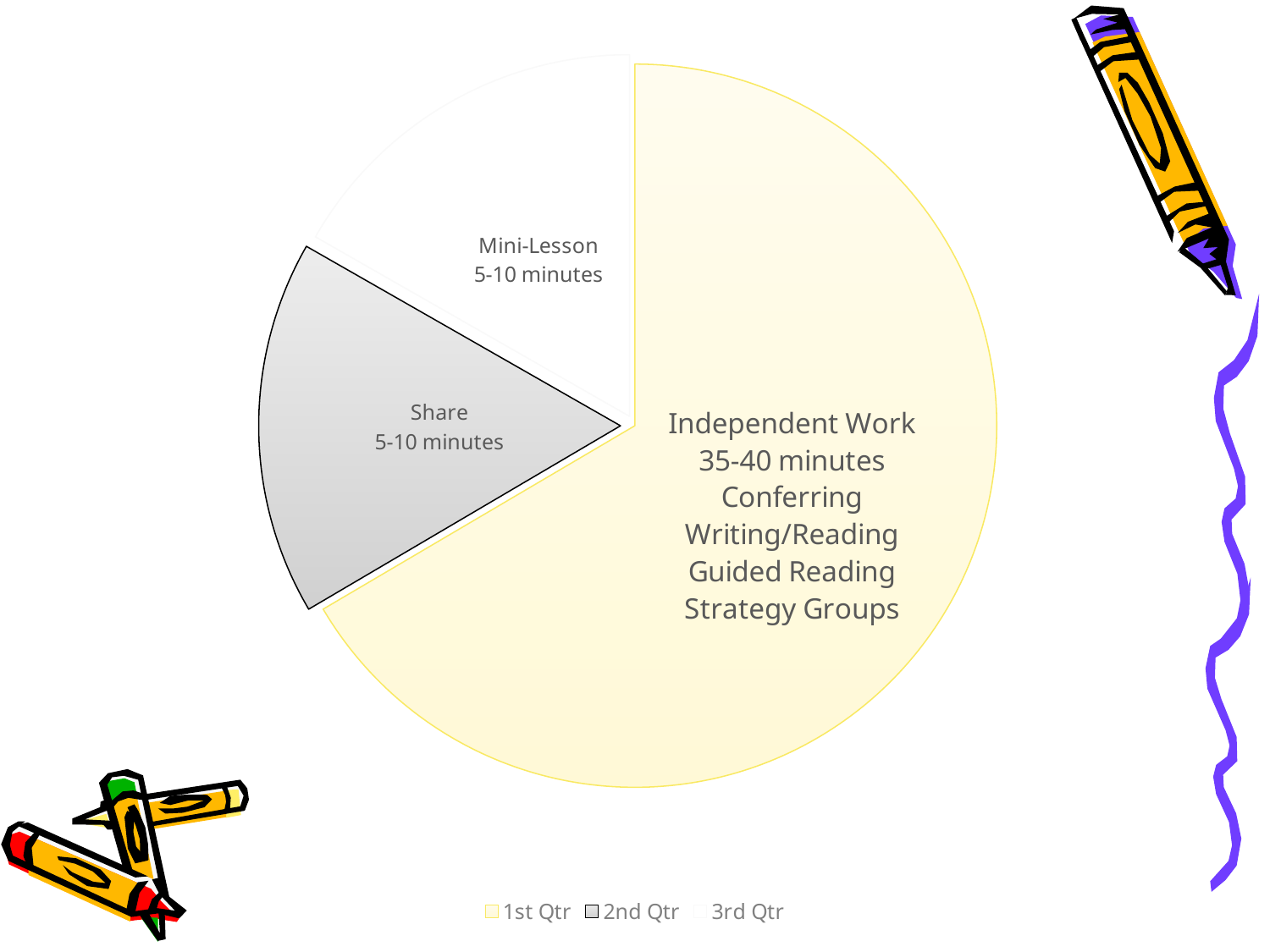
How many slices does the pie chart have? 3 Which slice of the pie chart is shaded grey? Share Which slice is larger, Independent Work or Share? Independent Work How many minutes are labelled for the Mini-Lesson slice? 5-10 minutes How many minutes are labelled for the Independent Work slice? 35-40 minutes How many entries does the legend list? 3 Which slice is larger, Independent Work or Mini-Lesson? Independent Work What are the three entries listed in the legend? 1st Qtr, 2nd Qtr, 3rd Qtr How many minutes are labelled for the Share slice? 5-10 minutes Which slice of the pie chart is the largest? Independent Work What kind of chart is shown on the slide? pie chart